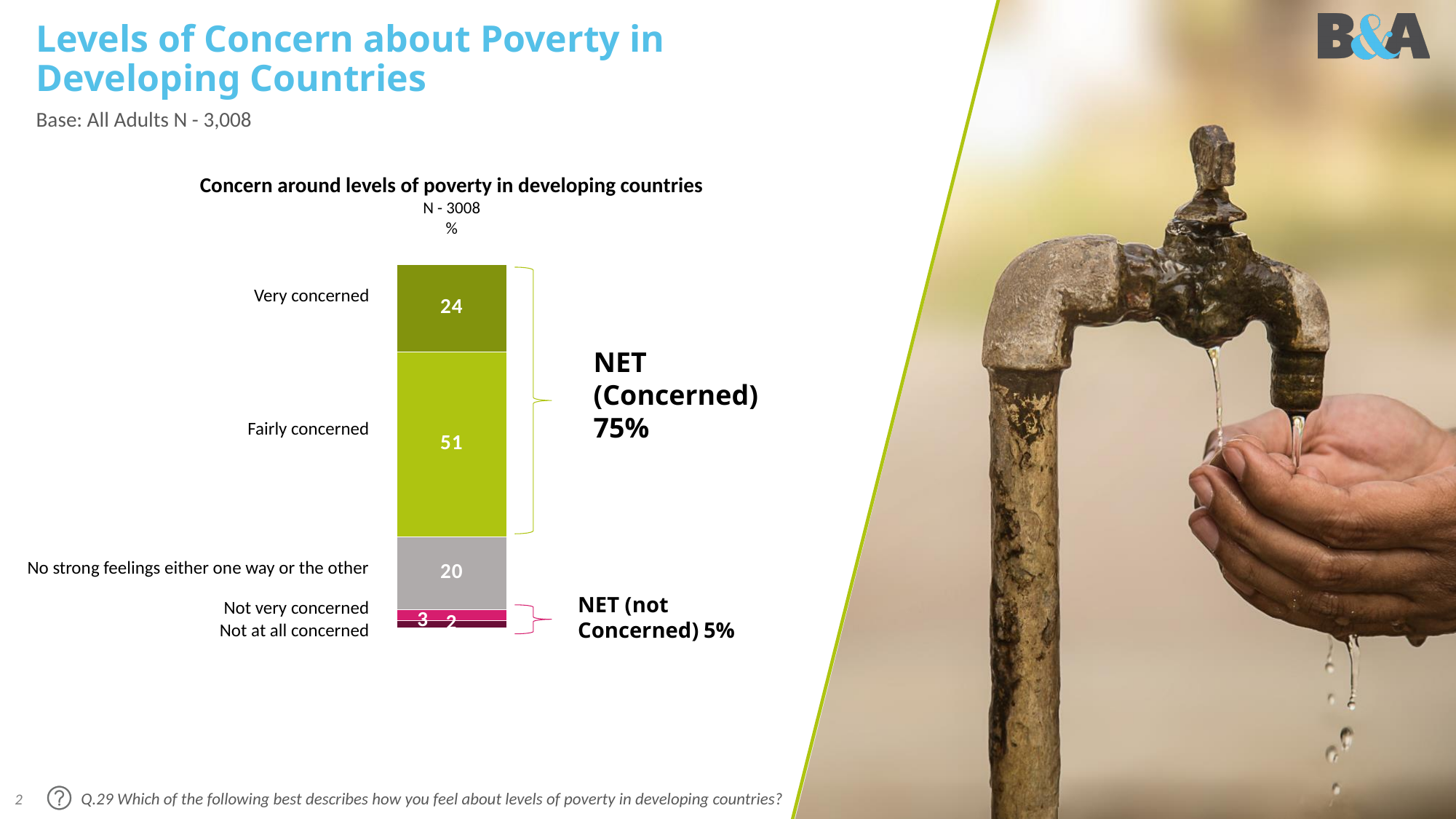
What type of chart is used to show concern around levels of poverty in developing countries? Stacked bar chart Which is larger, the percentage for 'Very concerned' or for 'No strong feelings either one way or the other'? Very concerned What is the difference in percentage points between 'Fairly concerned' and 'Very concerned'? 27 What percentage of adults are very concerned about levels of poverty in developing countries? 24 How many response categories are shown in the stacked bar? 5 What is the NET (Concerned) percentage shown on the chart? 75% What percentage of adults are fairly concerned about levels of poverty in developing countries? 51 Which response category has the lowest percentage? Not at all concerned What is the NET (not Concerned) percentage shown on the chart? 5% What percentage of adults have no strong feelings either one way or the other? 20 Which response category has the highest percentage? Fairly concerned What percentage of adults are not very concerned? 3